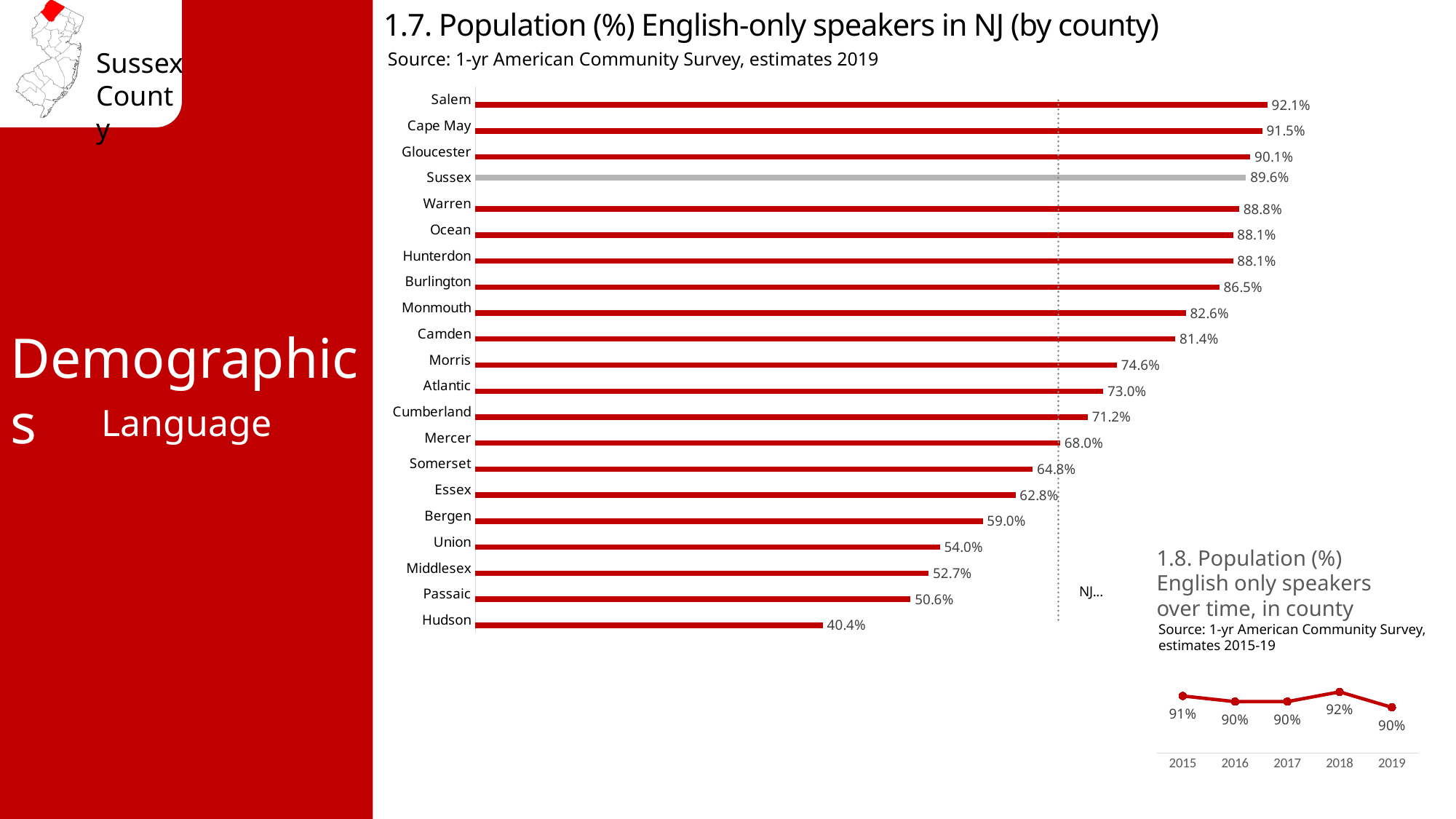
In the chart '1.7. Population (%) English-only speakers in NJ (by county)', which county's bar is coloured grey instead of red? Sussex In the chart '1.8. Population (%) English only speakers over time, in county', what is the value for 2018? 92% In the chart '1.7. Population (%) English-only speakers in NJ (by county)', how many counties are shown? 21 In the chart '1.7. Population (%) English-only speakers in NJ (by county)', what is the value for Passaic? 50.6% In the chart '1.7. Population (%) English-only speakers in NJ (by county)', which county has the lowest value? Hudson What kind of chart is '1.7. Population (%) English-only speakers in NJ (by county)'? Bar chart In the chart '1.7. Population (%) English-only speakers in NJ (by county)', what is the value for Sussex? 89.6% What kind of chart is '1.8. Population (%) English only speakers over time, in county'? Line chart In the chart '1.8. Population (%) English only speakers over time, in county', how many years are plotted? 5 In the chart '1.7. Population (%) English-only speakers in NJ (by county)', what is the difference between the values for Salem and Hudson? 51.7% In the chart '1.7. Population (%) English-only speakers in NJ (by county)', which is larger, the value for Morris or the value for Bergen? Morris In the chart '1.7. Population (%) English-only speakers in NJ (by county)', which county has the highest value? Salem